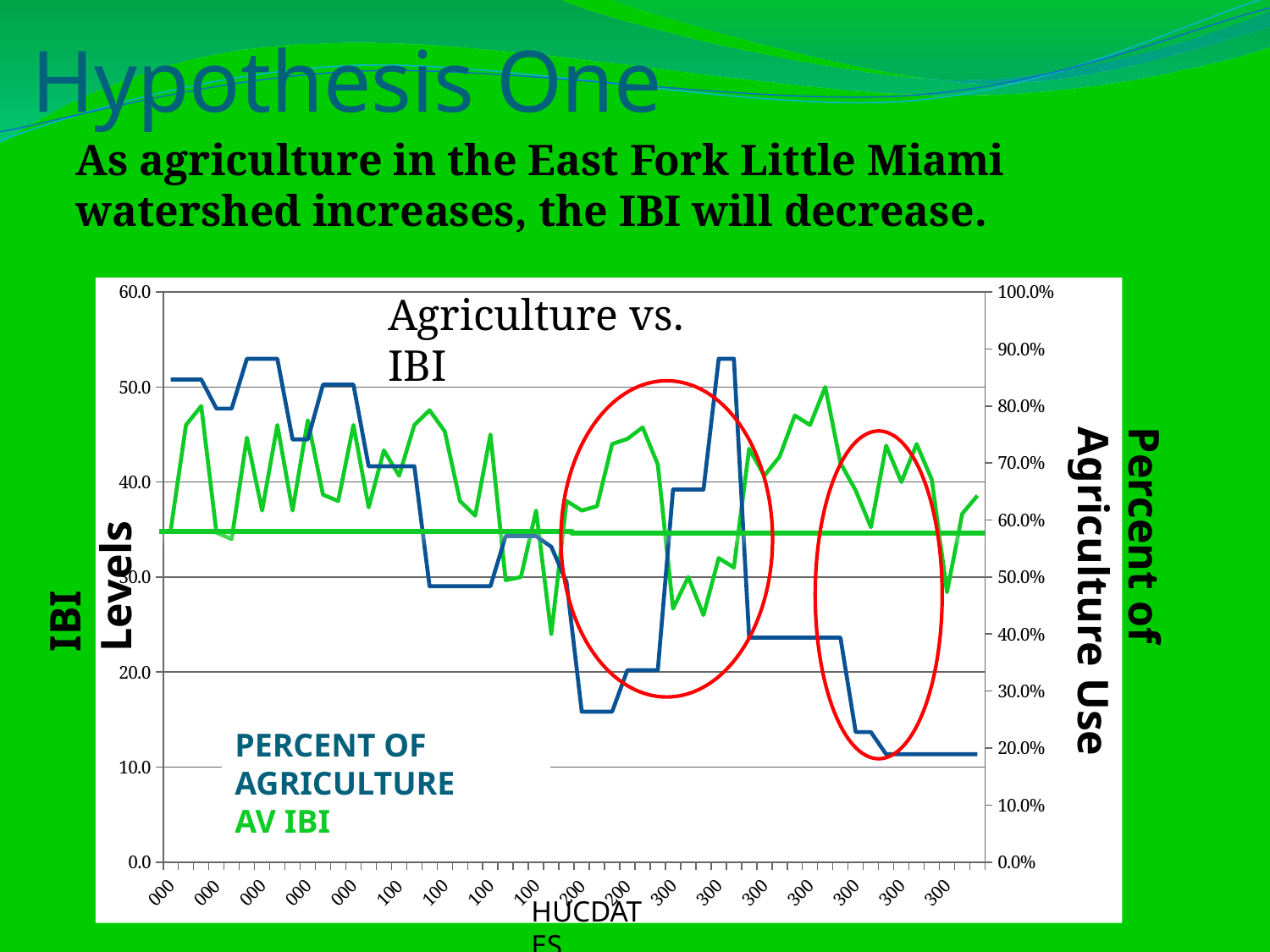
Is the value of the PERCENT OF AGRICULTURE line at the far right end of the chart greater or less than 30.0%? less How many series does the legend of the chart list? 2 Which colour is used for the PERCENT OF AGRICULTURE series? blue Is the highest value of the AV IBI line greater or less than 40.0? greater Is the highest value of the PERCENT OF AGRICULTURE line greater or less than 80.0%? greater Does the PERCENT OF AGRICULTURE line generally rise or fall from left to right across the x axis? fall What kind of chart is shown on the slide? line chart What is the title of the chart? Agriculture vs. IBI